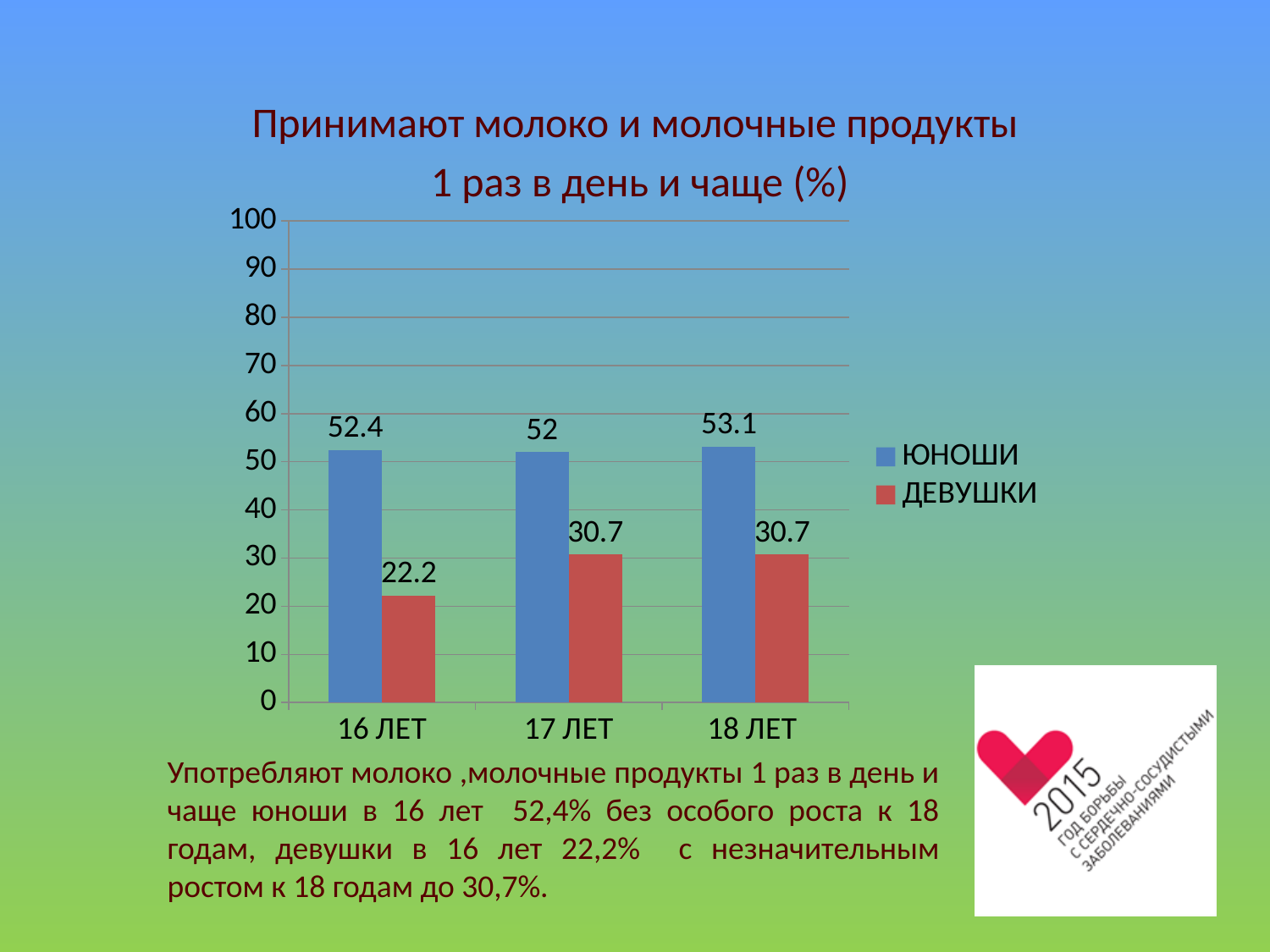
What is the value for ЮНОШИ at 18 ЛЕТ? 53.1 What is the value for ДЕВУШКИ at 16 ЛЕТ? 22.2 Which age group has the lowest value for ДЕВУШКИ? 16 ЛЕТ What is the difference between the ЮНОШИ and ДЕВУШКИ values at 16 ЛЕТ? 30.2 What kind of chart is shown on the slide? Bar chart Which is larger at 17 ЛЕТ, the value for ЮНОШИ or for ДЕВУШКИ? ЮНОШИ How many series does the legend list? 2 Which colour represents ДЕВУШКИ in the chart? Red What is the value for ЮНОШИ at 16 ЛЕТ? 52.4 Which age group has the highest value for ЮНОШИ? 18 ЛЕТ What is the value for ДЕВУШКИ at 17 ЛЕТ? 30.7 How many age categories are shown on the x axis? 3